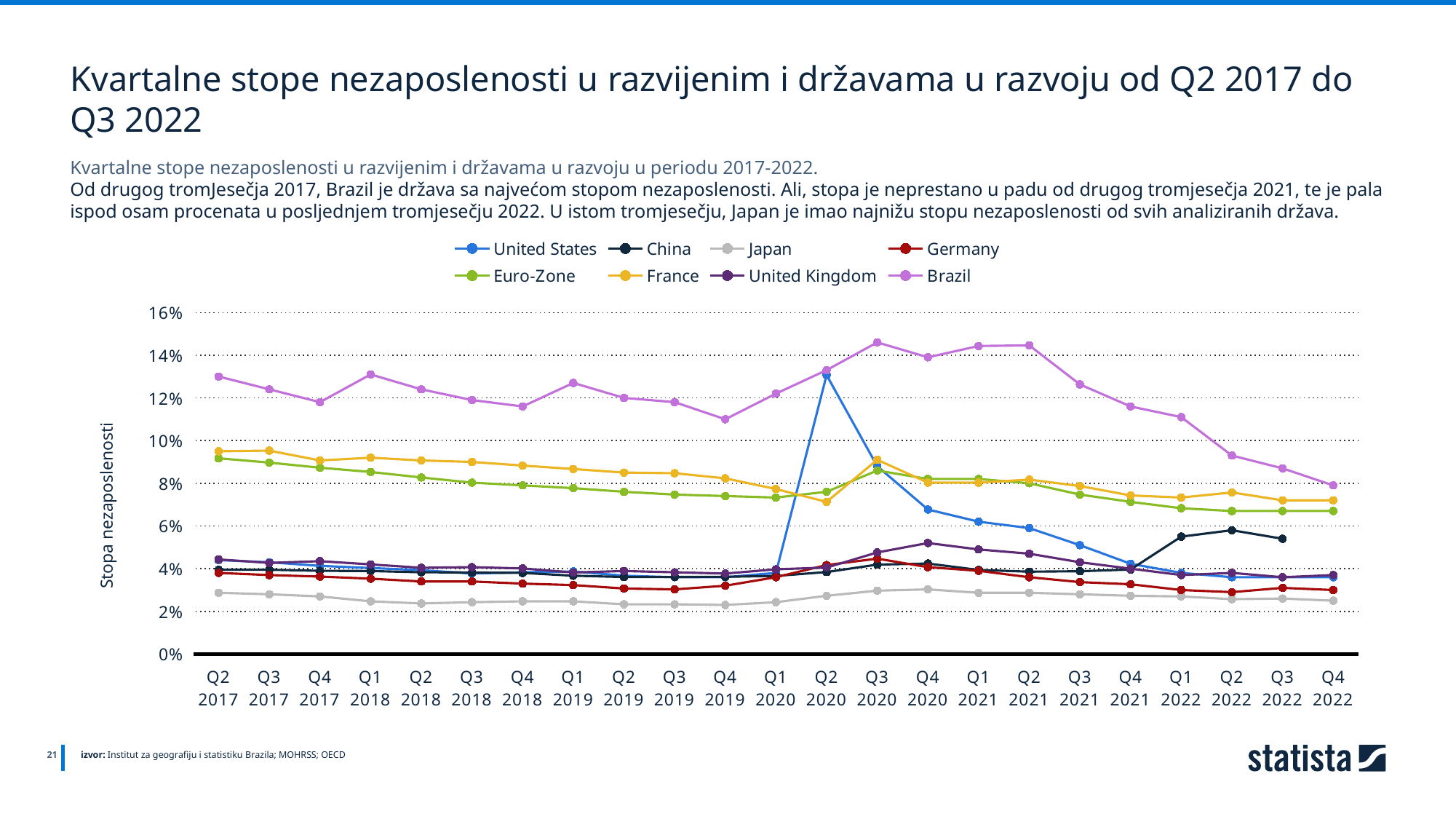
What is the label of the y axis? Stopa nezaposlenosti Is the value for China in Q2 2022 greater or less than 4%? greater How many series does the legend list? 8 Is the value for the United States in Q2 2020 greater or less than 12%? greater Does the Brazil line rise or fall from Q2 2021 to Q4 2022? fall Is the value for Brazil in Q3 2020 greater or less than 14%? greater In Q4 2022, which is higher: France or Euro-Zone? France Which country has the lowest unemployment rate in Q4 2022? Japan What kind of chart is shown on the slide? line chart Which country has the highest unemployment rate in Q2 2017? Brazil How many quarters are plotted along the x axis? 23